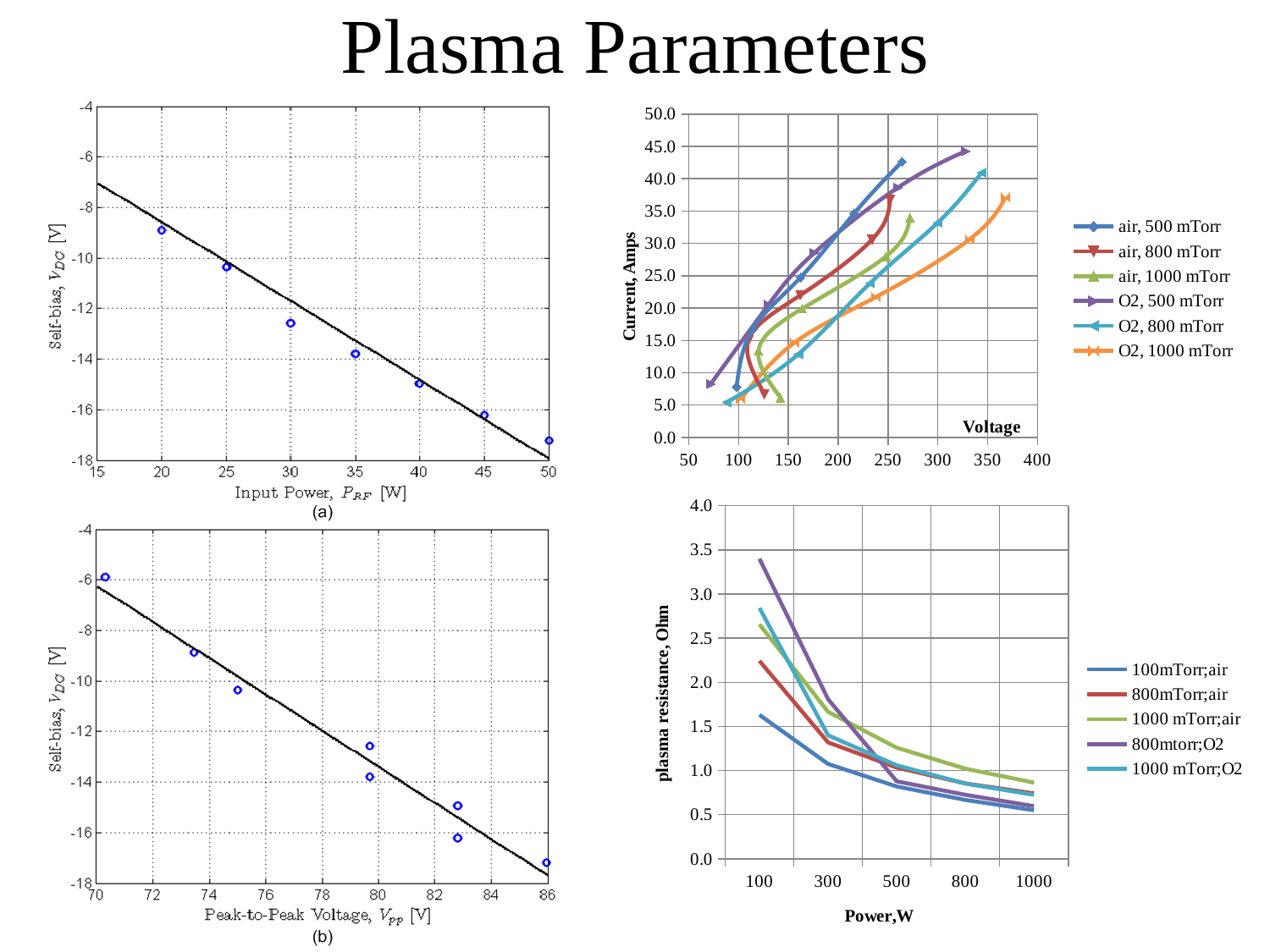
In the top-right chart, which series reaches the highest voltage? O2, 1000 mTorr In the top-right chart of current versus voltage, how many series does the legend list? 6 In the bottom-right chart of plasma resistance versus power, how many series does the legend list? 5 In the bottom-right chart, does plasma resistance rise or fall as power increases? fall In the bottom-right chart, is the plasma resistance for 800mtorr;O2 at 100 W greater or less than 3.0? greater In the bottom-right chart, which series has the highest plasma resistance at 100 W? 800mtorr;O2 In the bottom-right chart, which series has the lowest plasma resistance at 100 W? 100mTorr;air What kind of chart is the top-right chart of current versus voltage? line chart In chart (a), does the self-bias rise or fall as input power increases? fall In chart (a), how many data points are plotted? 7 In the bottom-right chart, is the plasma resistance for 100mTorr;air at 100 W greater or less than 2.0? less What is the x-axis label of the bottom-right chart? Power,W